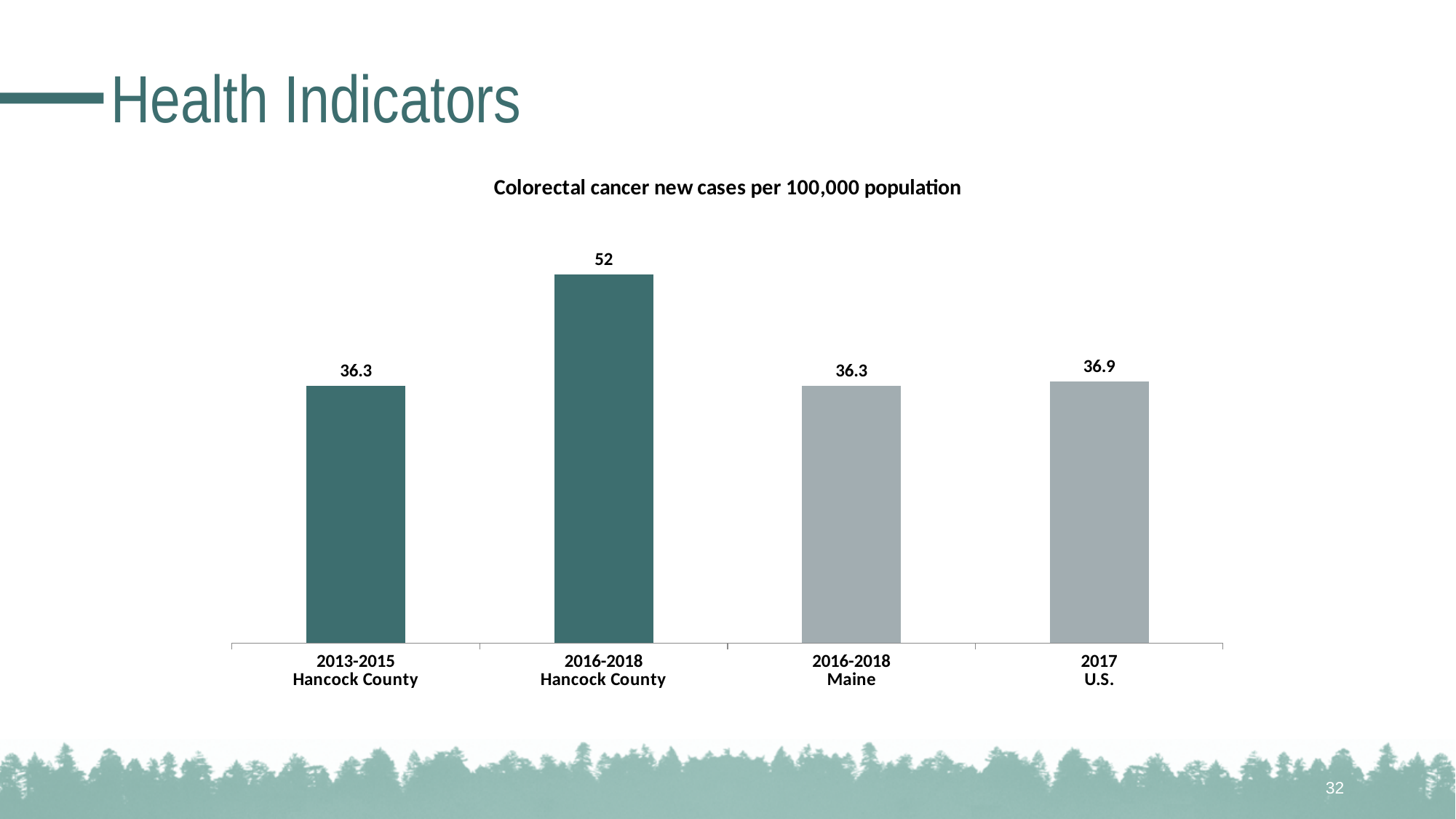
What is the title of the chart? Colorectal cancer new cases per 100,000 population What kind of chart is shown on the slide? Bar chart What is the value for 2013-2015 Hancock County? 36.3 Which is larger, the value for 2016-2018 Hancock County or the value for 2017 U.S.? 2016-2018 Hancock County How many bars are shown in the chart? 4 What is the difference between the 2016-2018 Hancock County value and the 2016-2018 Maine value? 15.7 What is the difference between the 2017 U.S. value and the 2013-2015 Hancock County value? 0.6 Which category has the highest value? 2016-2018 Hancock County What is the value for 2017 U.S.? 36.9 What is the value for 2016-2018 Maine? 36.3 What is the value for 2016-2018 Hancock County? 52 Did the Hancock County value rise or fall from 2013-2015 to 2016-2018? Rise